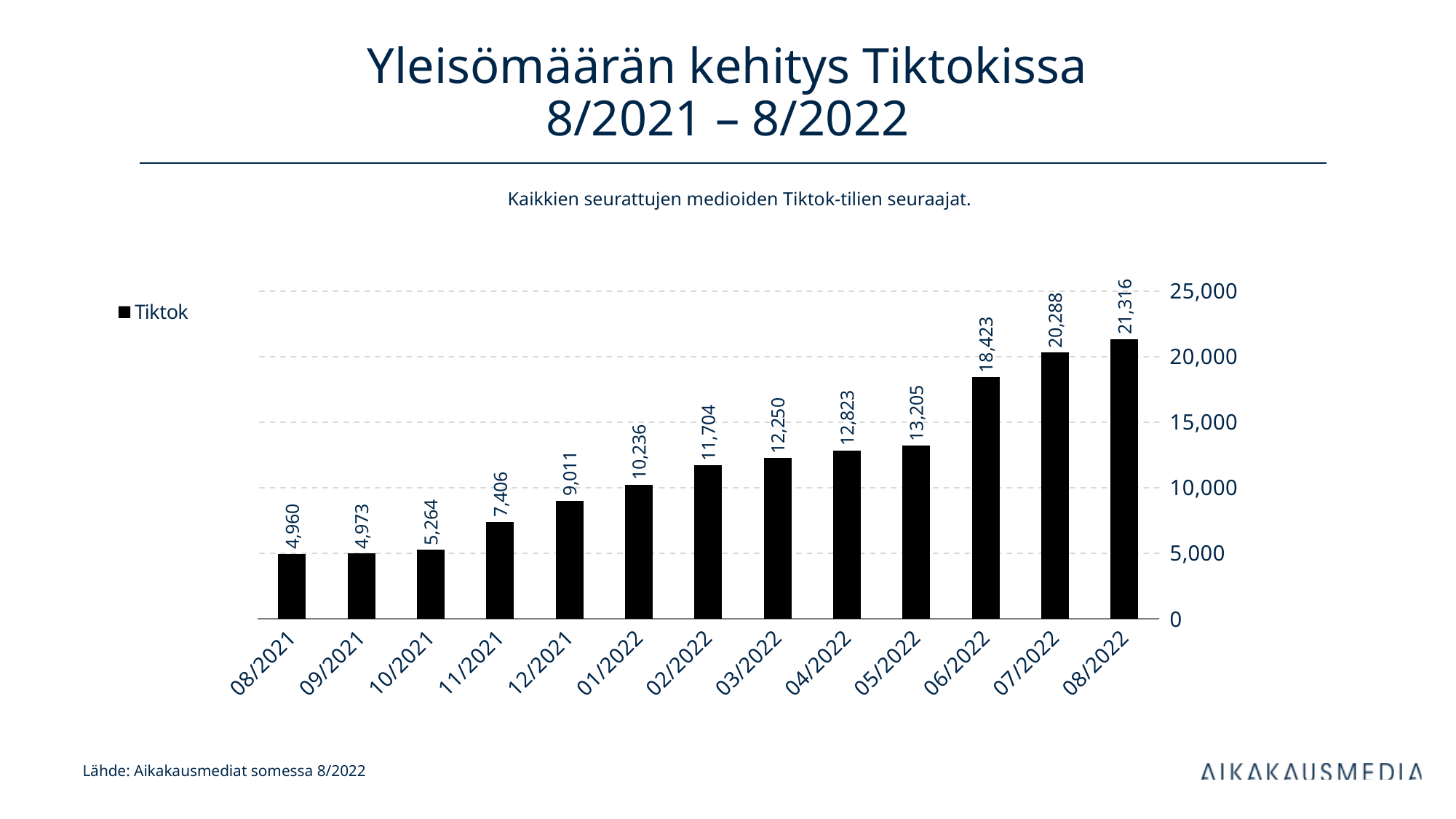
Which is larger, the value for 12/2021 or the value for 02/2022? 02/2022 How many months are shown on the x axis? 13 What is the value for 01/2022? 10,236 Which month has the lowest value? 08/2021 What is the difference between the values for 07/2022 and 06/2022? 1,865 What kind of chart is shown on the slide? bar chart What is the value for 08/2021? 4,960 What is the value for 08/2022? 21,316 Which month has the highest value? 08/2022 What is the difference between the values for 08/2022 and 08/2021? 16,356 Is the value for 06/2022 greater or less than 15,000? greater Do the values rise or fall from 08/2021 to 08/2022? rise